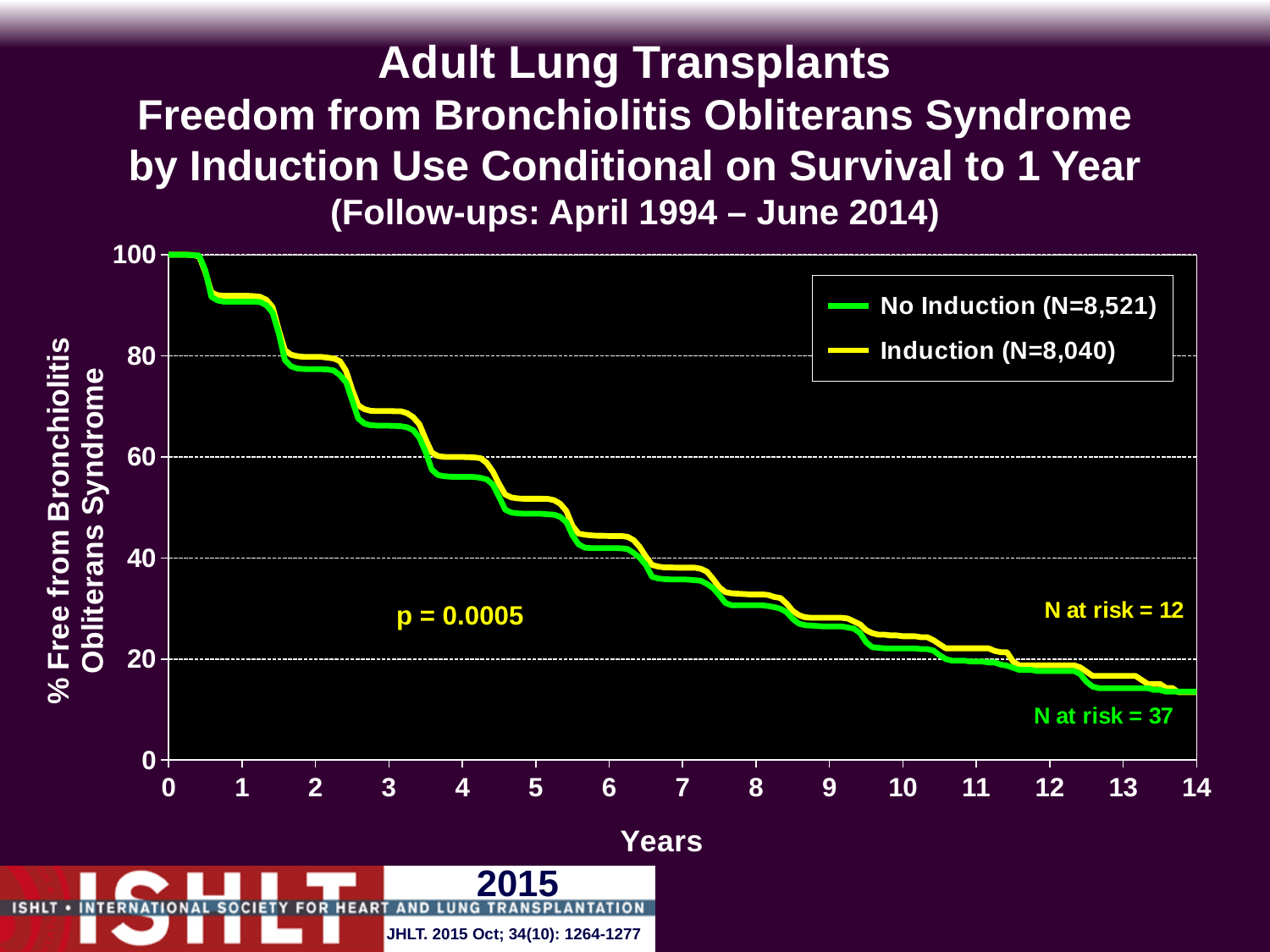
What is the N for the Induction group shown in the legend? 8,040 Do the curves rise or fall as years increase along the x axis? fall At year 4, which curve is higher, Induction or No Induction? Induction At year 2, is the value for the No Induction curve greater or less than 60? greater What is the N for the No Induction group shown in the legend? 8,521 What is the N at risk printed for the No Induction (green) curve at the end of follow-up? 37 What is the N at risk printed for the Induction (yellow) curve at the end of follow-up? 12 How many series does the legend list? 2 What kind of chart is shown on the slide? line chart What p-value is printed on the chart? p = 0.0005 At year 10, is the value for the No Induction curve greater or less than 40? less